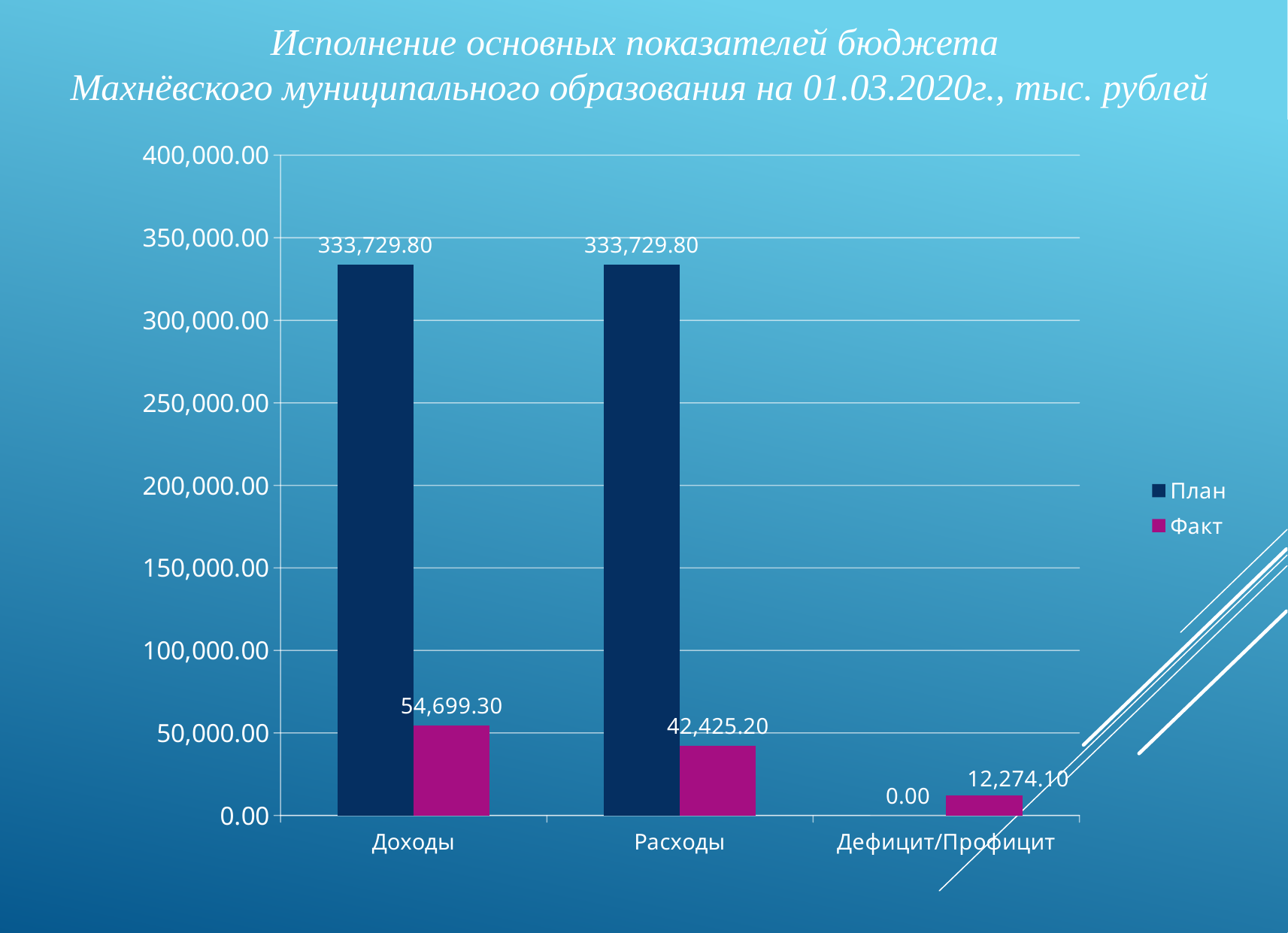
How many categories are shown on the x axis? 3 What is the План value for Доходы? 333,729.80 Which category has the lowest План value? Дефицит/Профицит What is the Факт value for Дефицит/Профицит? 12,274.10 What is the difference between the План and Факт values for Доходы? 279,030.50 Which is larger, the Факт value for Доходы or the Факт value for Расходы? Доходы What is the difference between the Факт values for Доходы and Расходы? 12,274.10 Which category has the highest Факт value? Доходы What kind of chart is shown on the slide? Bar chart What is the Факт value for Расходы? 42,425.20 What is the План value for Дефицит/Профицит? 0.00 How many series does the legend list? 2